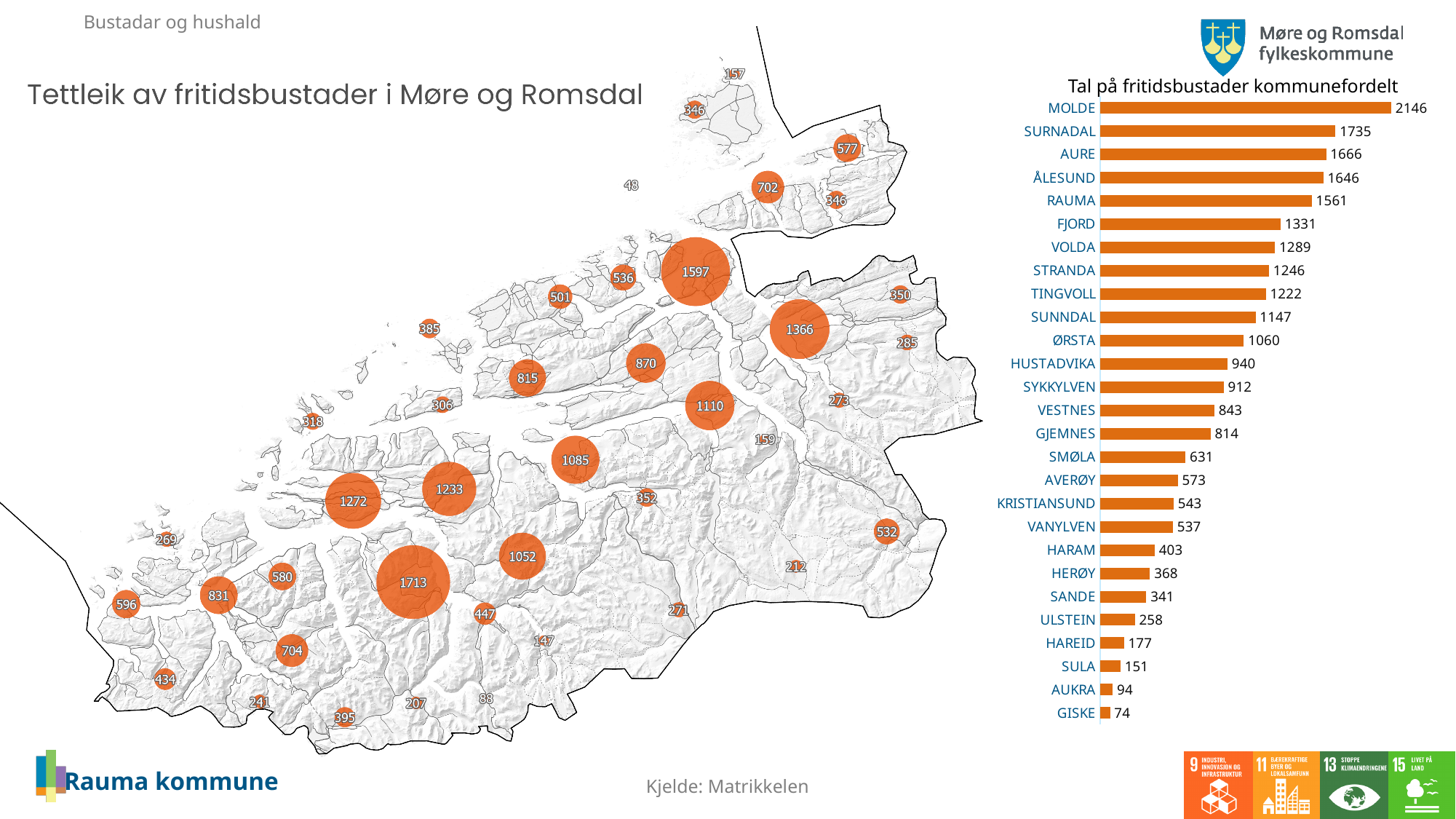
How many municipalities are shown in the bar chart 'Tal på fritidsbustader kommunefordelt'? 27 In the bar chart 'Tal på fritidsbustader kommunefordelt', what is the difference between the values for HARAM and HERØY? 35 What is the title of the bar chart on the right side of the slide? Tal på fritidsbustader kommunefordelt In the bar chart 'Tal på fritidsbustader kommunefordelt', what is the value for RAUMA? 1561 In the bar chart 'Tal på fritidsbustader kommunefordelt', which municipality has the highest value? MOLDE In the bar chart 'Tal på fritidsbustader kommunefordelt', which municipality has the lowest value? GISKE What kind of chart is 'Tal på fritidsbustader kommunefordelt'? Bar chart In the bar chart 'Tal på fritidsbustader kommunefordelt', which has a larger value, FJORD or VOLDA? FJORD In the bar chart 'Tal på fritidsbustader kommunefordelt', what is the difference between the values for MOLDE and SURNADAL? 411 In the bar chart 'Tal på fritidsbustader kommunefordelt', which has a larger value, SMØLA or KRISTIANSUND? SMØLA In the bar chart 'Tal på fritidsbustader kommunefordelt', what is the value for AUKRA? 94 In the bar chart 'Tal på fritidsbustader kommunefordelt', what is the value for SYKKYLVEN? 912